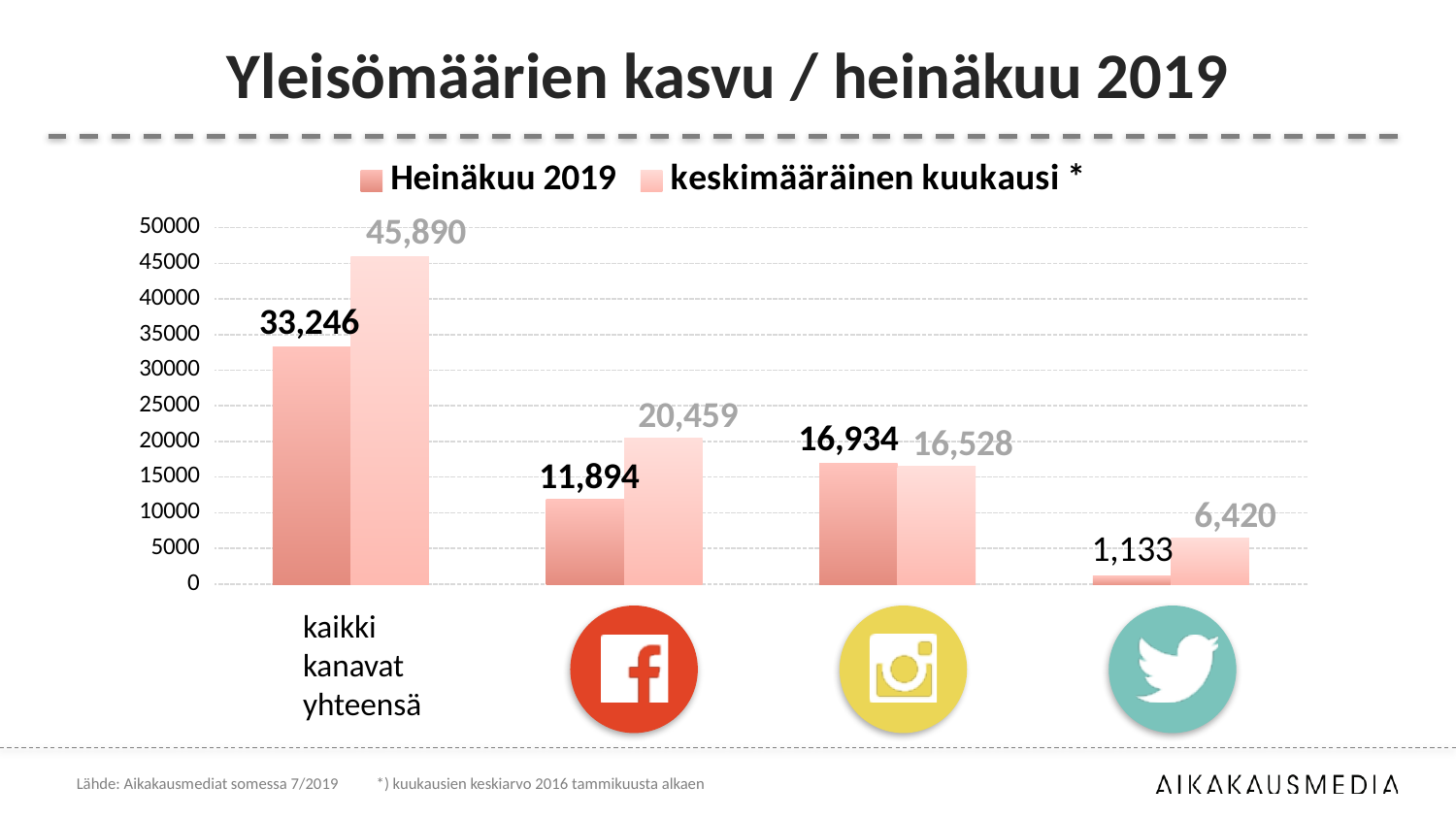
What is the difference between the keskimääräinen kuukausi and Heinäkuu 2019 values for the Facebook category? 8,565 What is the title of the slide? Yleisömäärien kasvu / heinäkuu 2019 What is the keskimääräinen kuukausi value for the Twitter category? 6,420 How many series does the legend list? 2 Which category has the lowest Heinäkuu 2019 value? Twitter What is the Heinäkuu 2019 value for the Facebook category? 11,894 What is the keskimääräinen kuukausi value for "kaikki kanavat yhteensä"? 45,890 Is the keskimääräinen kuukausi value for the Facebook category greater or less than 20000? greater What kind of chart is shown on the slide? Bar chart How many categories are shown on the x axis? 4 What is the Heinäkuu 2019 value for "kaikki kanavat yhteensä"? 33,246 For the Instagram category, which is larger: the Heinäkuu 2019 value or the keskimääräinen kuukausi value? Heinäkuu 2019